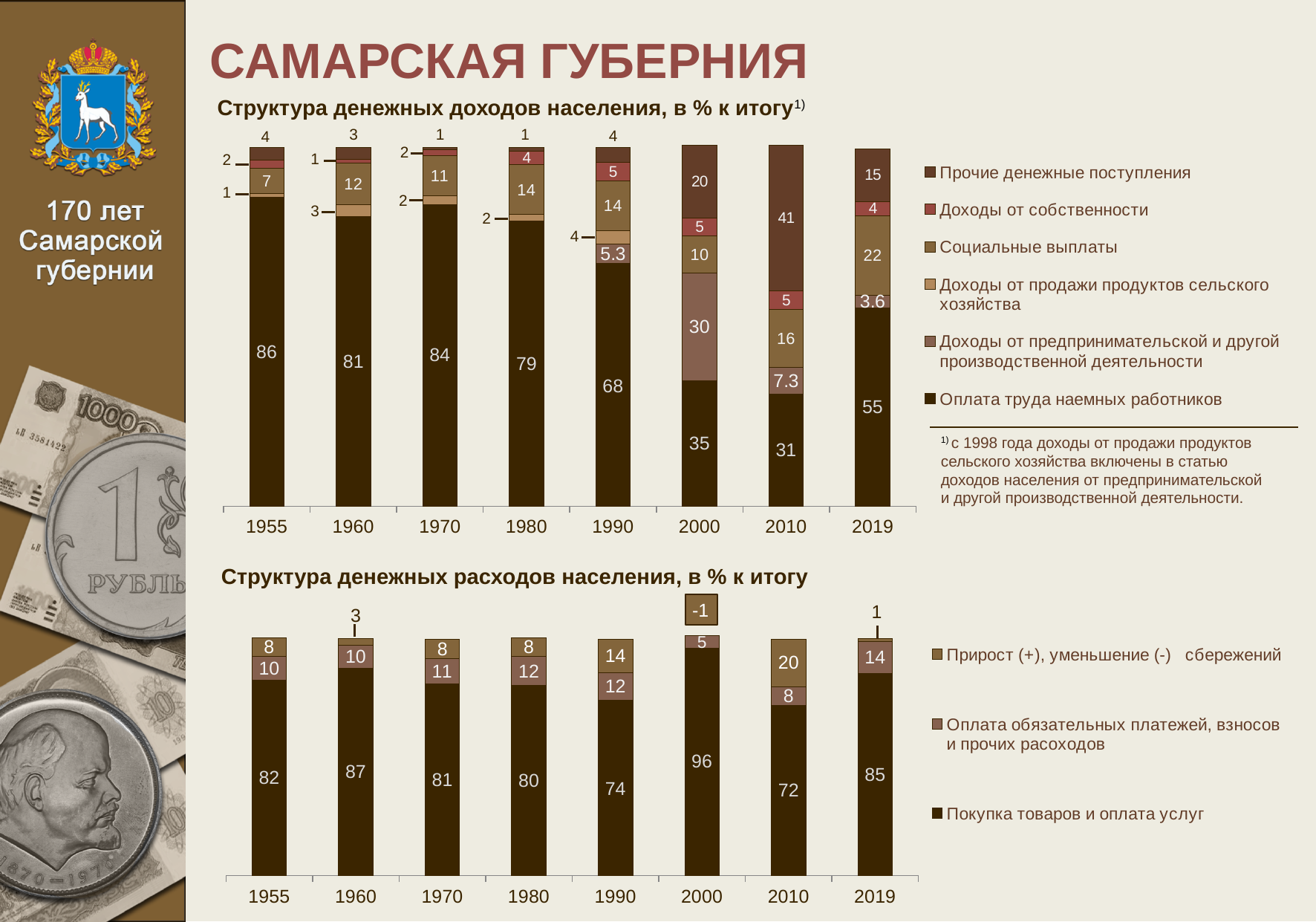
In the chart 'Структура денежных доходов населения', what is the value for 'Прочие денежные поступления' in 2010? 41 In the chart 'Структура денежных расходов населения', how many years are shown on the x axis? 8 In the chart 'Структура денежных доходов населения', in which year is 'Оплата труда наемных работников' the lowest? 2010 In the chart 'Структура денежных доходов населения', how many series does the legend list? 6 In the chart 'Структура денежных расходов населения', what is the value for 'Прирост (+), уменьшение (-) сбережений' in 2000? -1 In the chart 'Структура денежных расходов населения', which is larger: 'Оплата обязательных платежей, взносов и прочих расоходов' in 2019 or in 2010? 2019 What kind of chart is 'Структура денежных расходов населения'? Stacked bar chart In the chart 'Структура денежных доходов населения', what is the difference between 'Социальные выплаты' in 2019 and in 1955? 15 In the chart 'Структура денежных расходов населения', what is the value for 'Покупка товаров и оплата услуг' in 2000? 96 In the chart 'Структура денежных доходов населения', what is the value for 'Оплата труда наемных работников' in 2000? 35 In the chart 'Структура денежных доходов населения', in which year is 'Оплата труда наемных работников' the highest? 1955 In the chart 'Структура денежных расходов населения', what is the total of the 2010 bar? 100